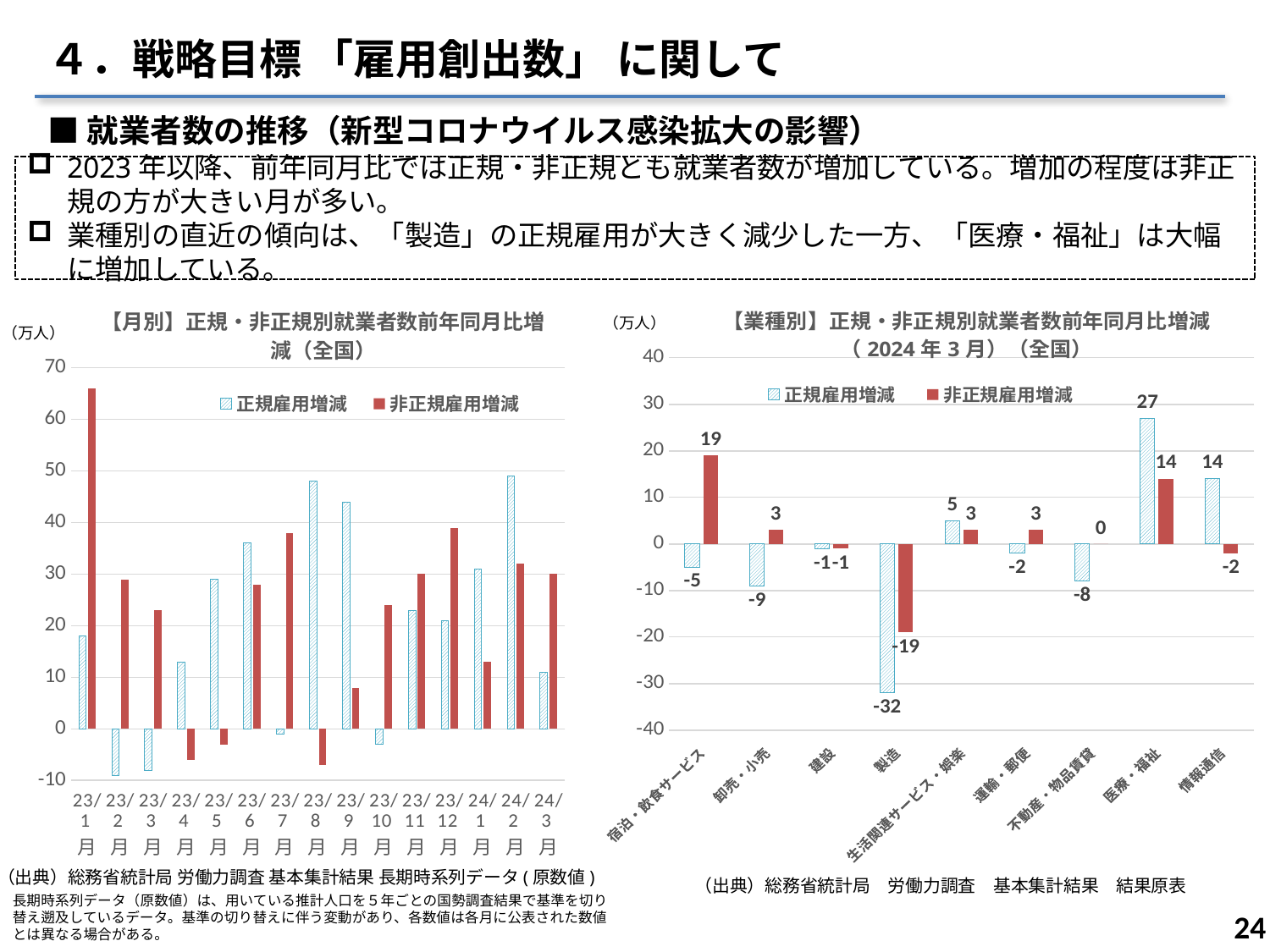
In the right chart (【業種別】), which is larger for 情報通信: 正規雇用増減 or 非正規雇用増減? 正規雇用増減 How many months are shown on the x axis of the left chart (【月別】)? 15 In the right chart (【業種別】), which industry has the lowest 非正規雇用増減 value? 製造 In the right chart (【業種別】), which industry has the highest 正規雇用増減 value? 医療・福祉 In the right chart (【業種別】), what is the 非正規雇用増減 value for 不動産・物品賃貸? 0 In the right chart (【業種別】), what is the 正規雇用増減 value for 製造? -32 In the right chart (【業種別】), what is the 非正規雇用増減 value for 宿泊・飲食サービス? 19 How many industries are shown on the x axis of the right chart (【業種別】)? 9 In the left chart (【月別】), is the 正規雇用増減 value for 24/2月 greater or less than 40? greater In the left chart (【月別】), is the 非正規雇用増減 value for 23/1月 greater or less than 60? greater In the right chart (【業種別】), what is the difference between the 正規雇用増減 and 非正規雇用増減 values for 医療・福祉? 13 What type of chart is the left chart (【月別】)? bar chart